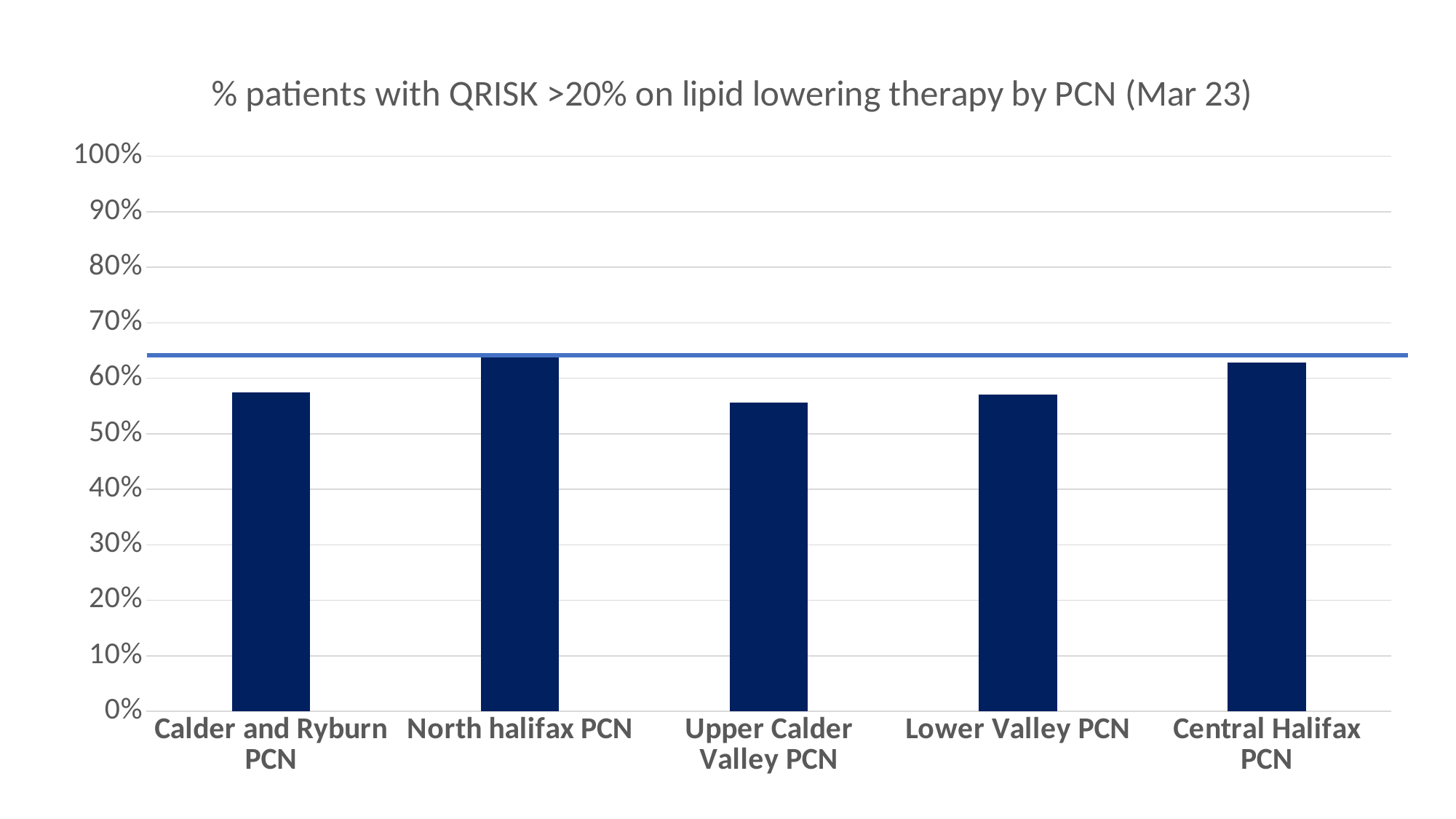
What type of chart is shown on the slide? bar chart How many PCNs are shown on the x axis of the chart? 5 Is the value for Central Halifax PCN greater or less than 60%? greater Which has a higher value, Central Halifax PCN or Calder and Ryburn PCN? Central Halifax PCN Which has a higher value, North halifax PCN or Upper Calder Valley PCN? North halifax PCN What is the highest value shown on the y axis of the chart? 100% Is the value for North halifax PCN greater or less than 70%? less What is the title of the chart? % patients with QRISK >20% on lipid lowering therapy by PCN (Mar 23) Is the value for Upper Calder Valley PCN greater or less than 60%? less